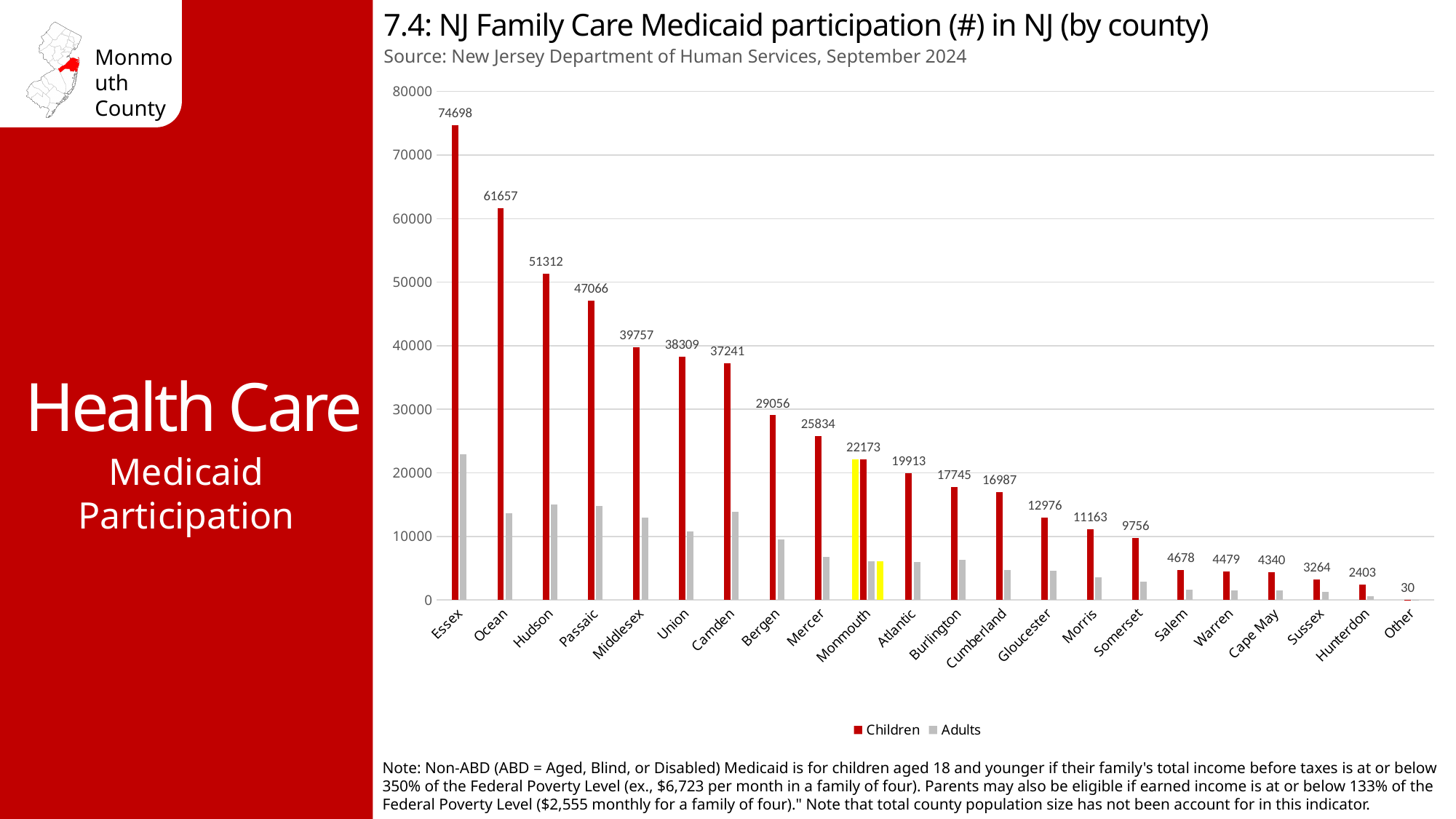
Which has a larger Children value, Bergen or Mercer? Bergen How many series does the legend list? 2 What is the difference between the Children values for Essex and Ocean? 13041 Which county has the highest Children value? Essex What kind of chart is shown on the slide? Bar chart Is the Adults value for Essex greater or less than 20000? greater What is the Children value for Hunterdon? 2403 Which category has the lowest Children value? Other What is the Children value for Monmouth? 22173 What is the Children value for Essex? 74698 Is the Adults value for Monmouth greater or less than 10000? less How many categories are shown on the x axis? 22